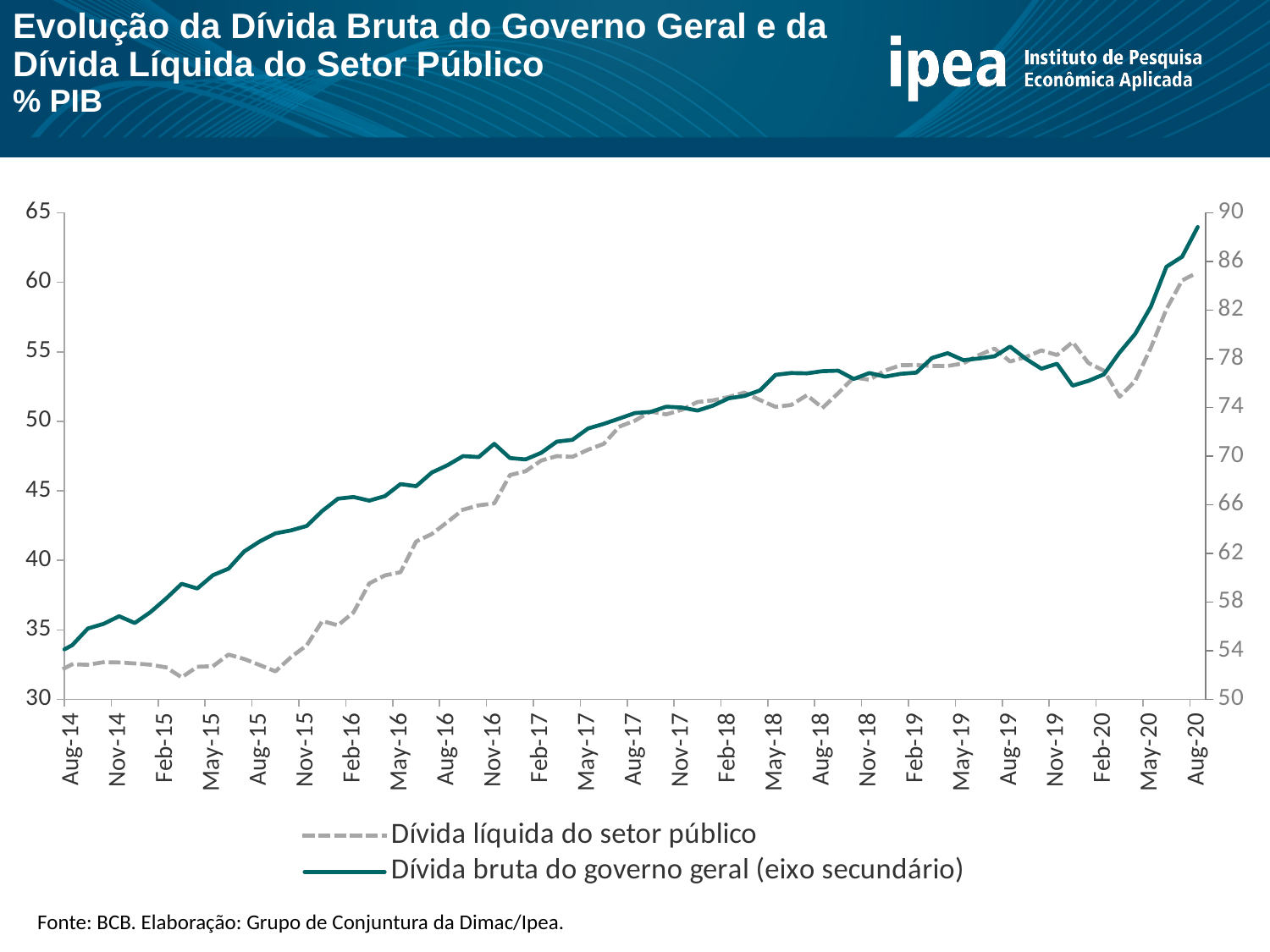
Which series is plotted on the secondary (right-hand) axis? Dívida bruta do governo geral Which series is drawn with a dashed grey line? Dívida líquida do setor público Overall, do the values of Dívida líquida do setor público rise or fall from Aug-14 to Aug-20? rise At which date does Dívida bruta do governo geral reach its highest value? Aug-20 How many series does the legend list? 2 Is the value of Dívida bruta do governo geral at Aug-14 (secondary axis) greater or less than 58? less At which date is Dívida bruta do governo geral at its lowest value? Aug-14 Is the value of Dívida líquida do setor público at Aug-14 greater or less than 35? less Is the value of Dívida líquida do setor público at Aug-20 greater or less than 55? greater Overall, do the values of Dívida bruta do governo geral rise or fall from Aug-14 to Aug-20? rise What kind of chart is shown on the slide? line chart